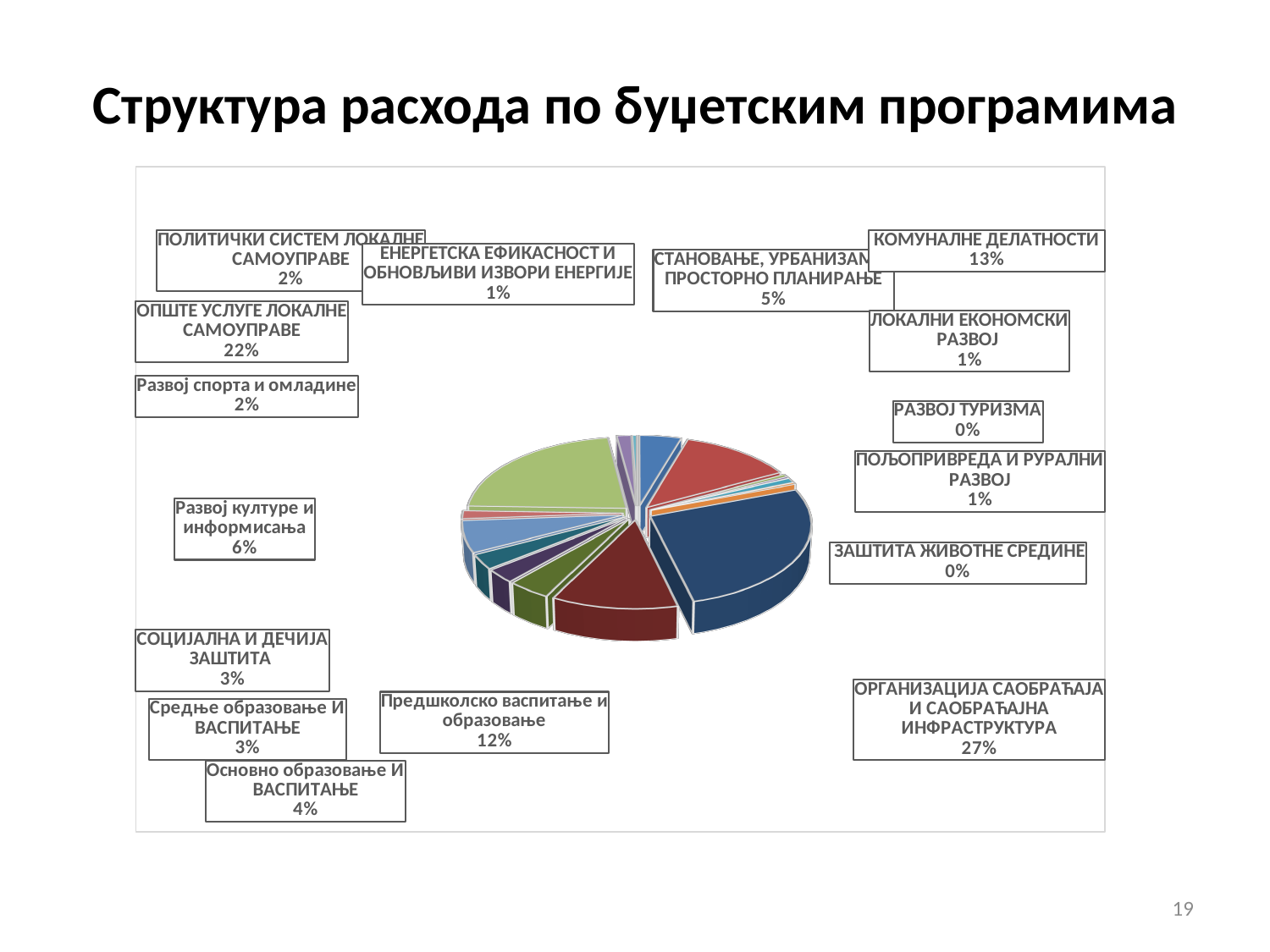
Which has a larger share: Развој културе и информисања or Основно образовање И ВАСПИТАЊЕ? Развој културе и информисања Which budget program has the largest share of expenditure? ОРГАНИЗАЦИЈА САОБРАЋАЈА И САОБРАЋАЈНА ИНФРАСТРУКТУРА Which two budget programs are labelled with 0%? РАЗВОЈ ТУРИЗМА and ЗАШТИТА ЖИВОТНЕ СРЕДИНЕ What share does Предшколско васпитање и образовање have? 12% What is the difference in percentage points between ОРГАНИЗАЦИЈА САОБРАЋАЈА И САОБРАЋАЈНА ИНФРАСТРУКТУРА and ОПШТЕ УСЛУГЕ ЛОКАЛНЕ САМОУПРАВЕ? 5 percentage points What percentage is shown for СОЦИЈАЛНА И ДЕЧИЈА ЗАШТИТА? 3% What percentage is shown for КОМУНАЛНЕ ДЕЛАТНОСТИ? 13% What share of expenditure goes to ОРГАНИЗАЦИЈА САОБРАЋАЈА И САОБРАЋАЈНА ИНФРАСТРУКТУРА? 27% What is the title of the slide's chart? Структура расхода по буџетским програмима What type of chart is shown on the slide? Pie chart What percentage is shown for ОПШТЕ УСЛУГЕ ЛОКАЛНЕ САМОУПРАВЕ? 22% How many budget programs (slices) are labelled in the pie chart? 16